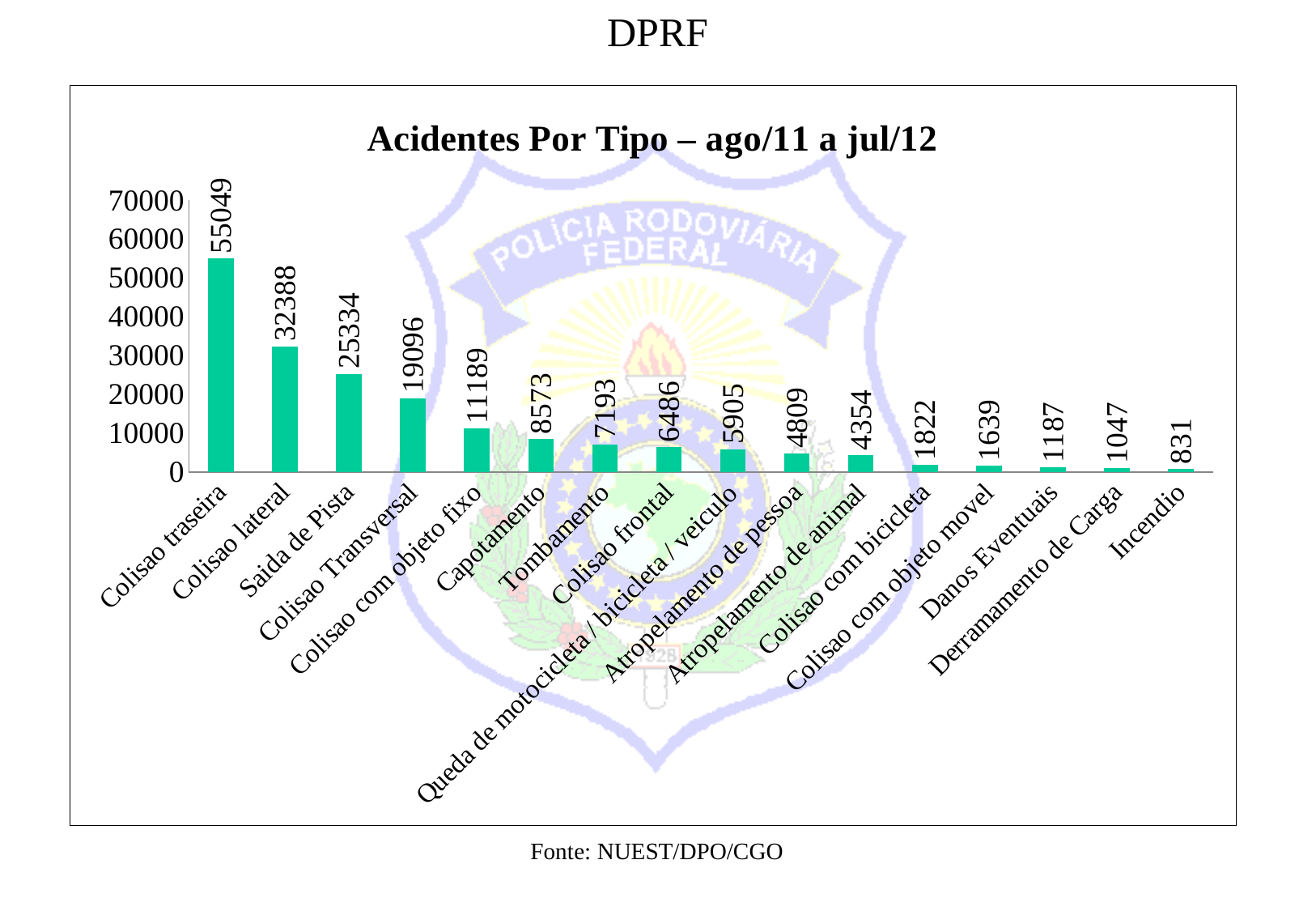
Which accident type has the lowest value? Incendio What is the value for Capotamento? 8573 Which accident type has the highest value? Colisao traseira Which is larger, Saida de Pista or Colisao Transversal? Saida de Pista What is the title of the chart? Acidentes Por Tipo – ago/11 a jul/12 What kind of chart is shown on the slide? Bar chart What is the value for Derramamento de Carga? 1047 What is the difference between Colisao traseira and Colisao lateral? 22661 What is the value for Colisao traseira? 55049 What is the difference between Capotamento and Tombamento? 1380 What is the value for Atropelamento de animal? 4354 How many accident types are shown in the chart? 16